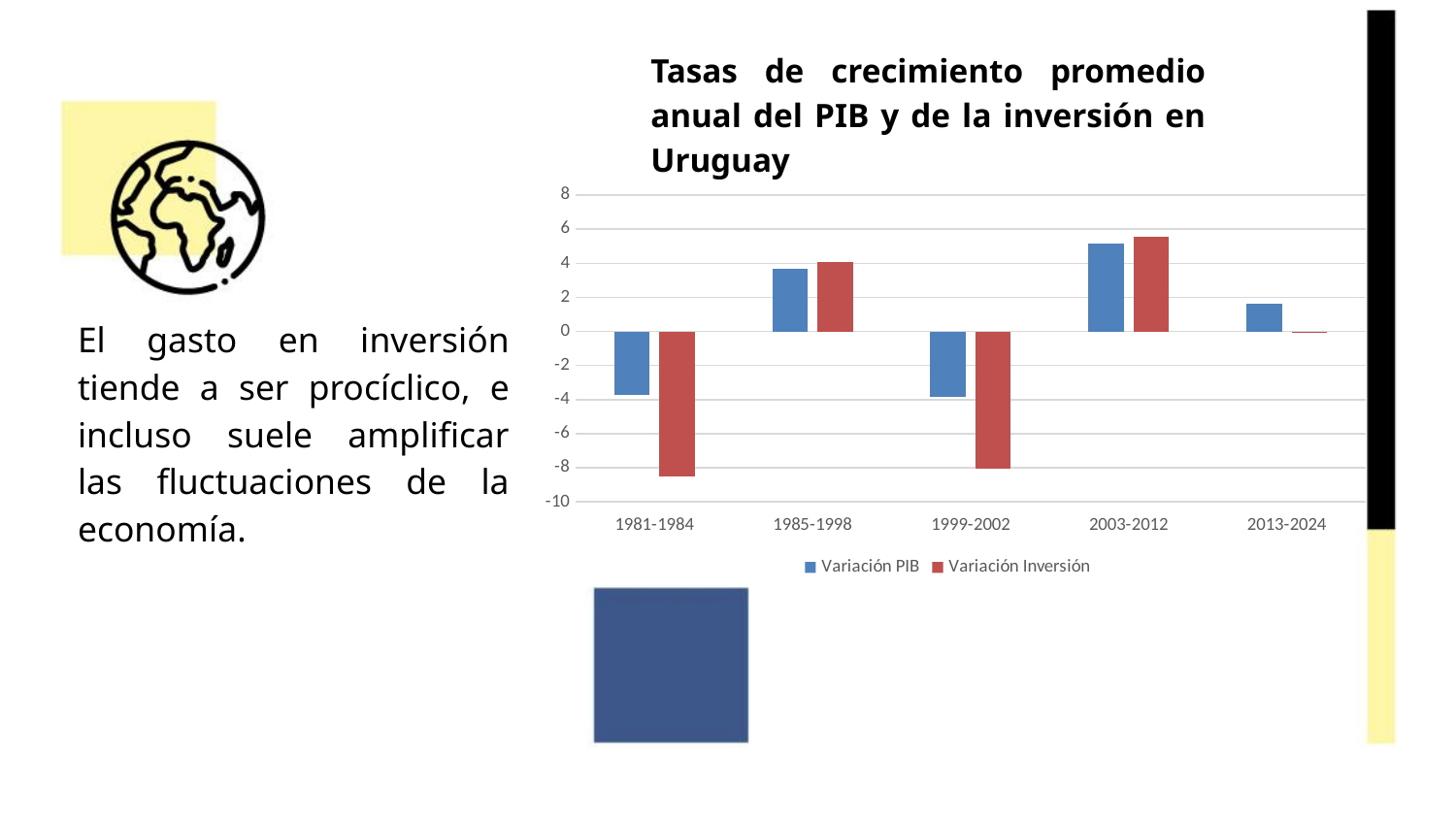
Is the value of Variación Inversión for 1999-2002 greater or less than -6? less What are the two series named in the chart's legend? Variación PIB and Variación Inversión Is the value of Variación PIB for 2003-2012 greater or less than 4? greater In which period is Variación PIB highest? 2003-2012 Is the value of Variación PIB for 2013-2024 greater or less than 2? less What kind of chart is shown on the slide? Bar chart What is the title of the chart? Tasas de crecimiento promedio anual del PIB y de la inversión en Uruguay For 2013-2024, which series has the larger value, Variación PIB or Variación Inversión? Variación PIB How many series does the chart's legend list? 2 In which period is Variación Inversión highest? 2003-2012 How many periods are shown on the x axis of the chart? 5